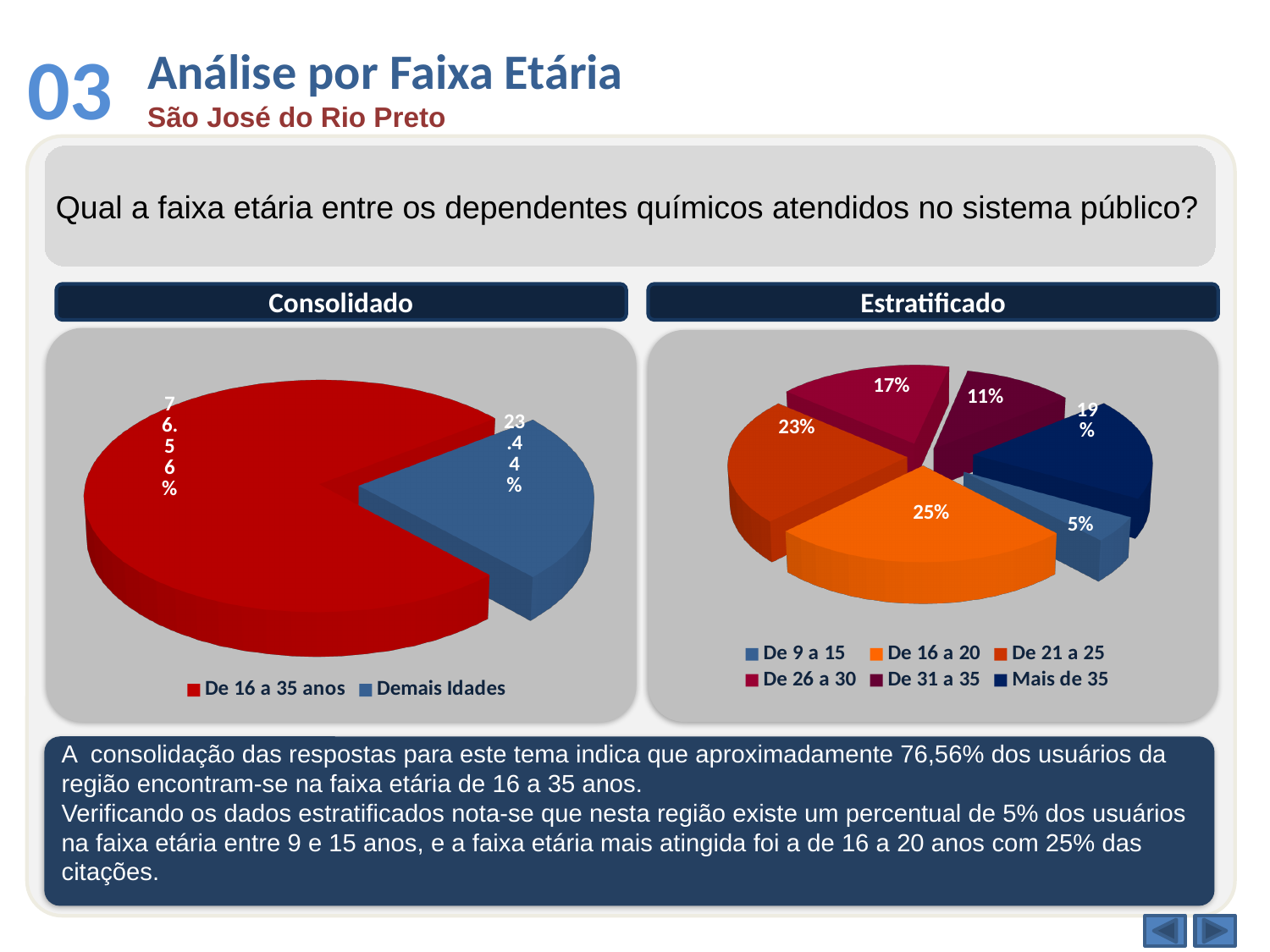
In the Estratificado chart, what is the value for Mais de 35? 19% In the Estratificado chart, which age group has the largest share? De 16 a 20 In the Estratificado chart, what is the difference between De 21 a 25 and De 26 a 30? 6% In the Consolidado chart, what colour is the De 16 a 35 anos slice? Red In the Consolidado chart, what is the value for Demais Idades? 23.44% What type of chart is the Consolidado chart? Pie chart In the Consolidado chart, what is the value for De 16 a 35 anos? 76.56% In the Estratificado chart, which is larger: De 31 a 35 or Mais de 35? Mais de 35 In the Estratificado chart, what is the value for De 9 a 15? 5% How many categories does the Estratificado chart show? 6 In the Estratificado chart, what is the value for De 16 a 20? 25% In the Estratificado chart, which age group has the smallest share? De 9 a 15